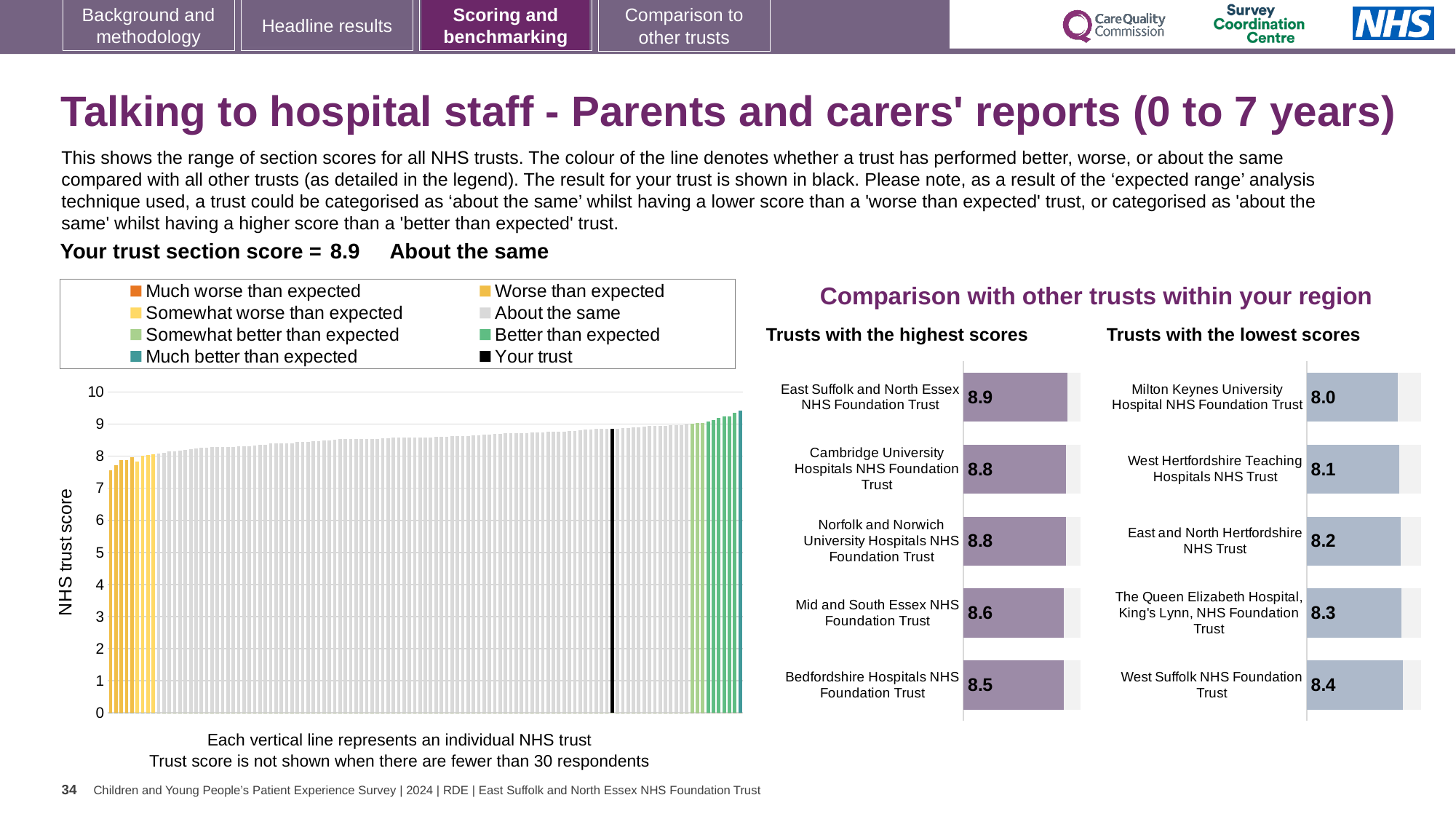
How many trusts are shown in the 'Trusts with the highest scores' chart? 5 In the 'Trusts with the highest scores' chart, what is the score for Mid and South Essex NHS Foundation Trust? 8.6 What kind of chart is the main 'NHS trust score' chart on the left of the slide? bar chart In the 'Trusts with the lowest scores' chart, what is the score for West Suffolk NHS Foundation Trust? 8.4 In the 'Trusts with the lowest scores' chart, which trust has the lowest score? Milton Keynes University Hospital NHS Foundation Trust In the 'Trusts with the highest scores' chart, which trust has the highest score? East Suffolk and North Essex NHS Foundation Trust In the main 'NHS trust score' chart on the left, do the trust scores rise or fall from left to right? rise In the 'Trusts with the highest scores' chart, which has the higher score: Cambridge University Hospitals NHS Foundation Trust or Mid and South Essex NHS Foundation Trust? Cambridge University Hospitals NHS Foundation Trust In the 'Trusts with the highest scores' chart, what is the difference between the scores of East Suffolk and North Essex NHS Foundation Trust and Bedfordshire Hospitals NHS Foundation Trust? 0.4 In the main 'NHS trust score' chart on the left, is the value for the black 'Your trust' bar greater or less than 8? greater How many entries does the legend of the main 'NHS trust score' chart on the left list? 8 In the 'Trusts with the lowest scores' chart, what is the difference between the scores of West Suffolk NHS Foundation Trust and Milton Keynes University Hospital NHS Foundation Trust? 0.4